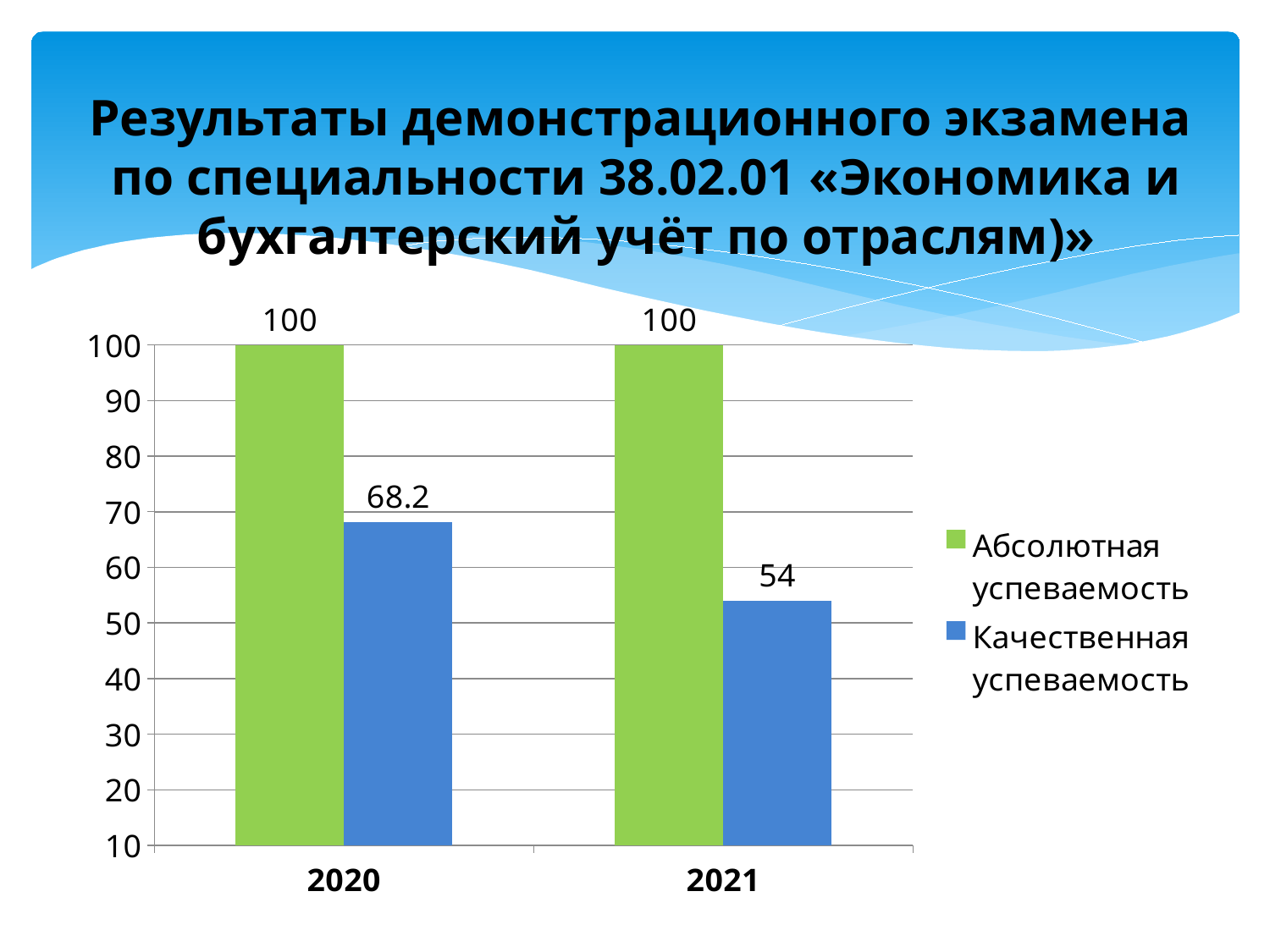
How many years are shown on the x axis? 2 What is the value of Качественная успеваемость for 2021? 54 What kind of chart is shown on the slide? bar chart Does Качественная успеваемость rise or fall from 2020 to 2021? fall How many series does the legend list? 2 Which is larger: Качественная успеваемость in 2020 or in 2021? 2020 What is the value of Абсолютная успеваемость for 2021? 100 What is the difference between Качественная успеваемость in 2020 and in 2021? 14.2 Which year has the lower value for Качественная успеваемость? 2021 What colour are the bars for Абсолютная успеваемость? green What is the value of Качественная успеваемость for 2020? 68.2 Is the value for Качественная успеваемость in 2021 greater or less than 60? less